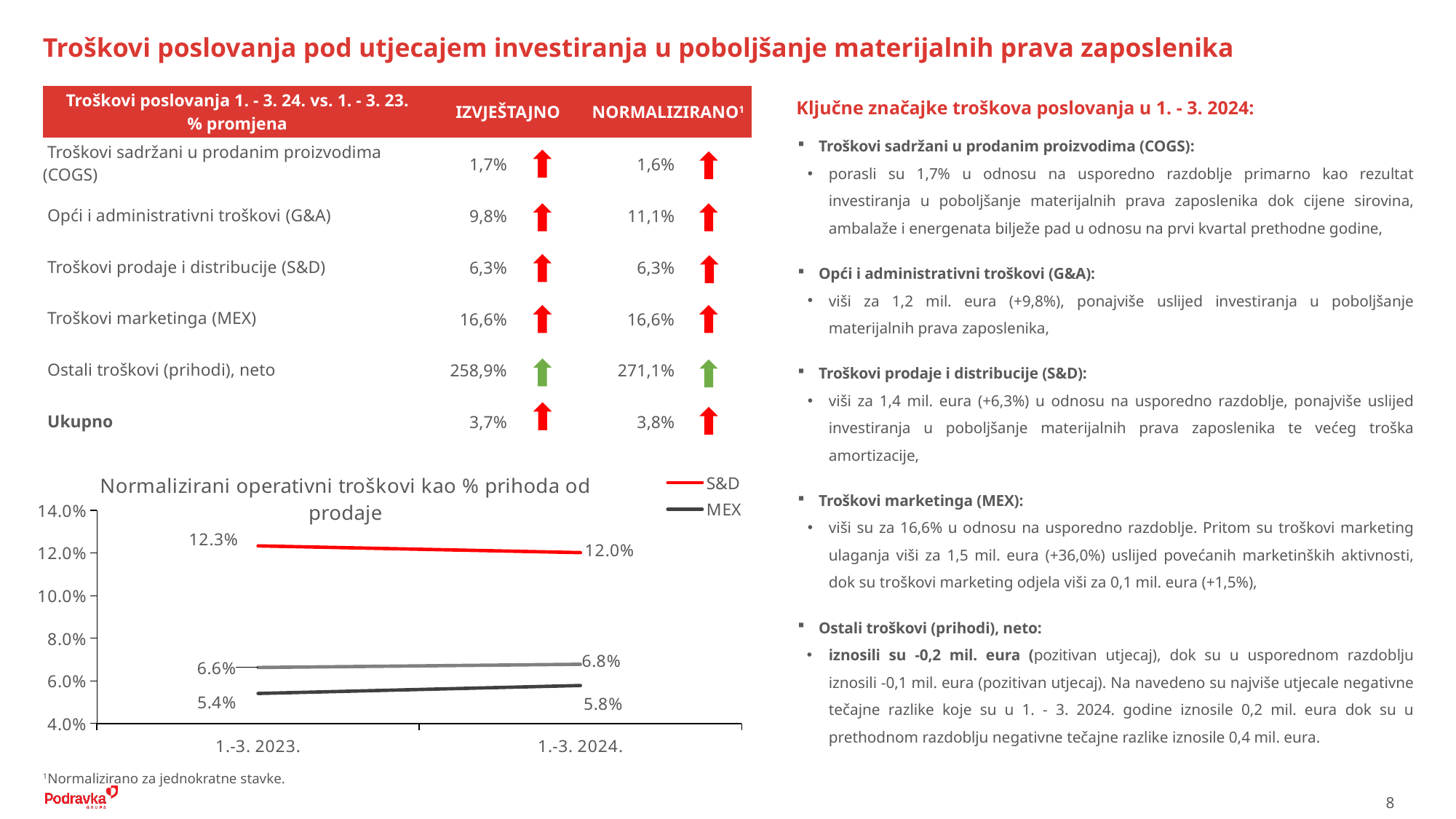
By how many percentage points did the S&D value change from 1.-3. 2023. to 1.-3. 2024.? 0.3 percentage points What is the S&D value for 1.-3. 2023. in the chart? 12.3% What is the MEX value for 1.-3. 2023. in the chart? 5.4% What is the title of the chart? Normalizirani operativni troškovi kao % prihoda od prodaje How many series does the chart legend list? 2 Does the MEX line rise or fall from 1.-3. 2023. to 1.-3. 2024.? rise How many periods are shown on the x axis of the chart? 2 Which series has the higher value in 1.-3. 2024., S&D or MEX? S&D What is the S&D value for 1.-3. 2024. in the chart? 12.0% Does the S&D line rise or fall from 1.-3. 2023. to 1.-3. 2024.? fall What kind of chart is shown on the slide? line chart What is the MEX value for 1.-3. 2024. in the chart? 5.8%